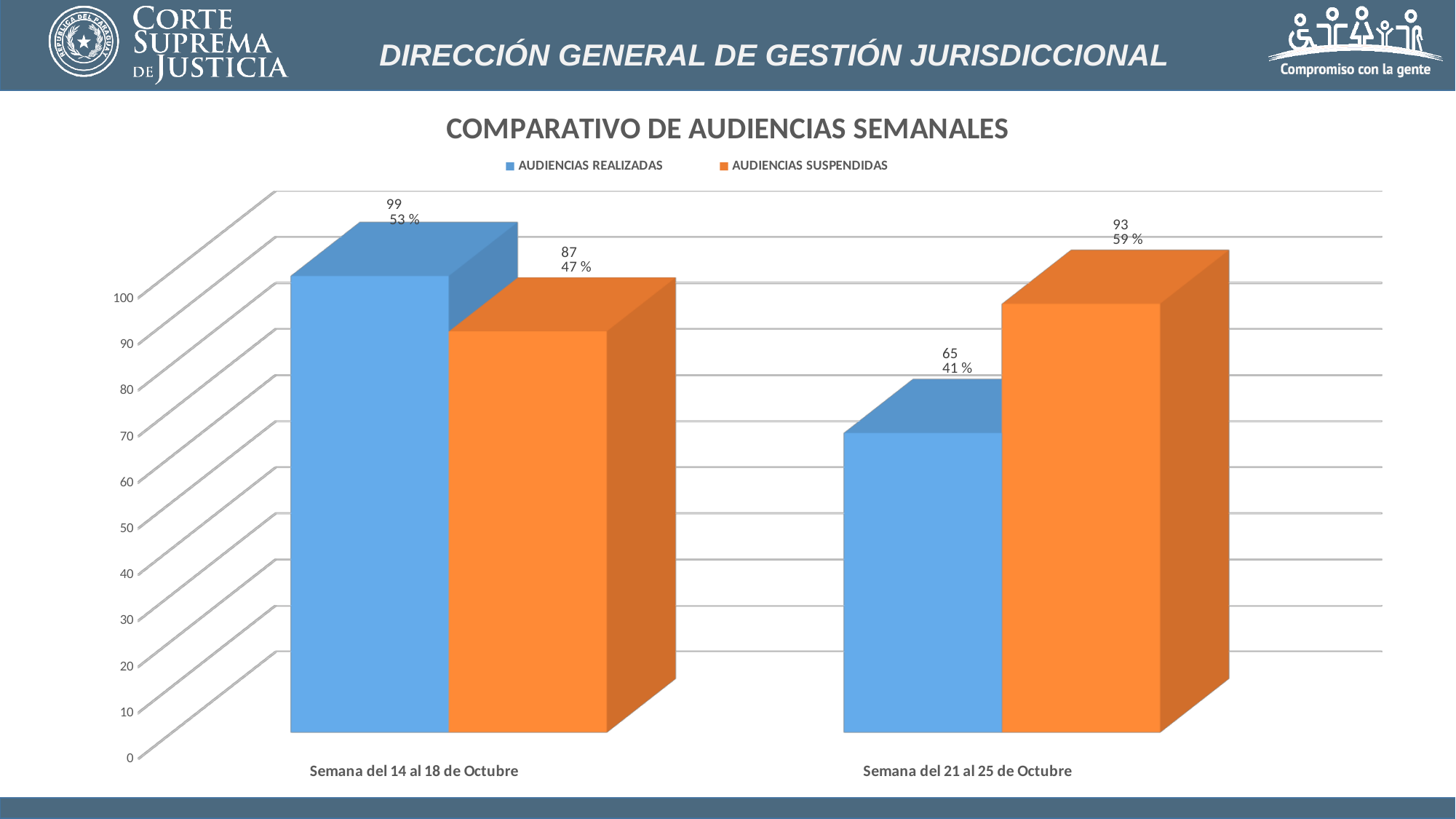
How many series does the legend list? 2 What is the value of AUDIENCIAS SUSPENDIDAS for Semana del 14 al 18 de Octubre? 87 What is the title of the chart? COMPARATIVO DE AUDIENCIAS SEMANALES What is the value of AUDIENCIAS REALIZADAS for Semana del 14 al 18 de Octubre? 99 What percentage label is shown for AUDIENCIAS REALIZADAS in Semana del 21 al 25 de Octubre? 41 % How many weeks (categories) are shown on the x axis? 2 Which week has the lower value for AUDIENCIAS SUSPENDIDAS? Semana del 14 al 18 de Octubre Which week has the higher value for AUDIENCIAS REALIZADAS? Semana del 14 al 18 de Octubre In Semana del 14 al 18 de Octubre, which is larger: AUDIENCIAS REALIZADAS or AUDIENCIAS SUSPENDIDAS? AUDIENCIAS REALIZADAS What is the value of AUDIENCIAS SUSPENDIDAS for Semana del 21 al 25 de Octubre? 93 What is the difference between AUDIENCIAS REALIZADAS and AUDIENCIAS SUSPENDIDAS in Semana del 21 al 25 de Octubre? 28 What kind of chart is shown on the slide? Bar chart